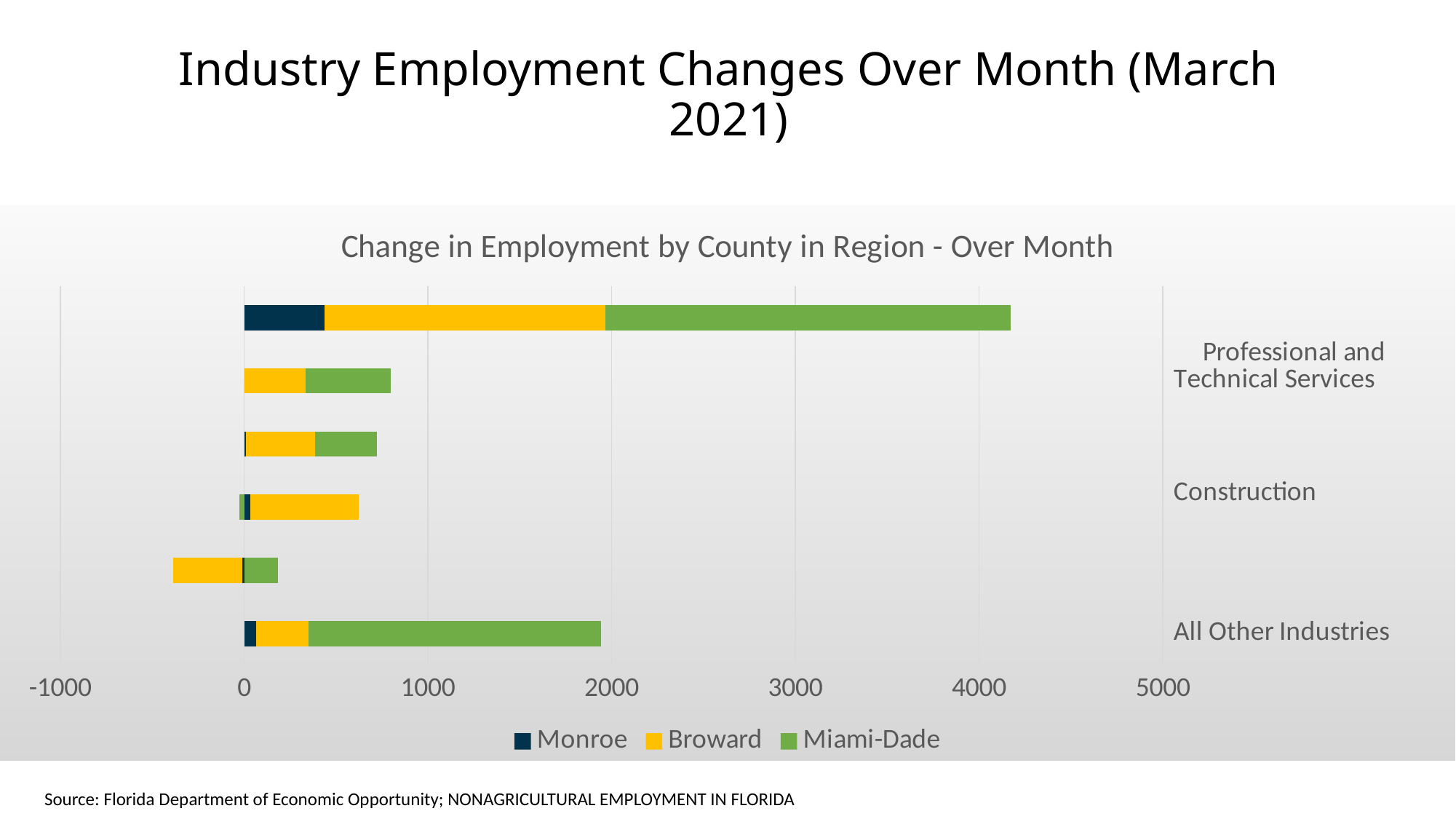
What is the title of the chart? Change in Employment by County in Region - Over Month Is the total of the All Other Industries bar greater or less than 1000? greater How many series does the legend list? 3 Is the Miami-Dade value for All Other Industries greater or less than 1000? greater Which county has the largest segment in the top bar of the chart? Miami-Dade Which county has the largest segment in the All Other Industries bar? Miami-Dade Which counties are listed in the chart legend? Monroe, Broward, Miami-Dade What kind of chart is shown on the slide? Stacked bar chart How many bars are plotted in the chart? 6 Is the Broward value in the second bar from the bottom greater or less than 0? less Which is larger in the top bar: the Broward segment or the Monroe segment? Broward